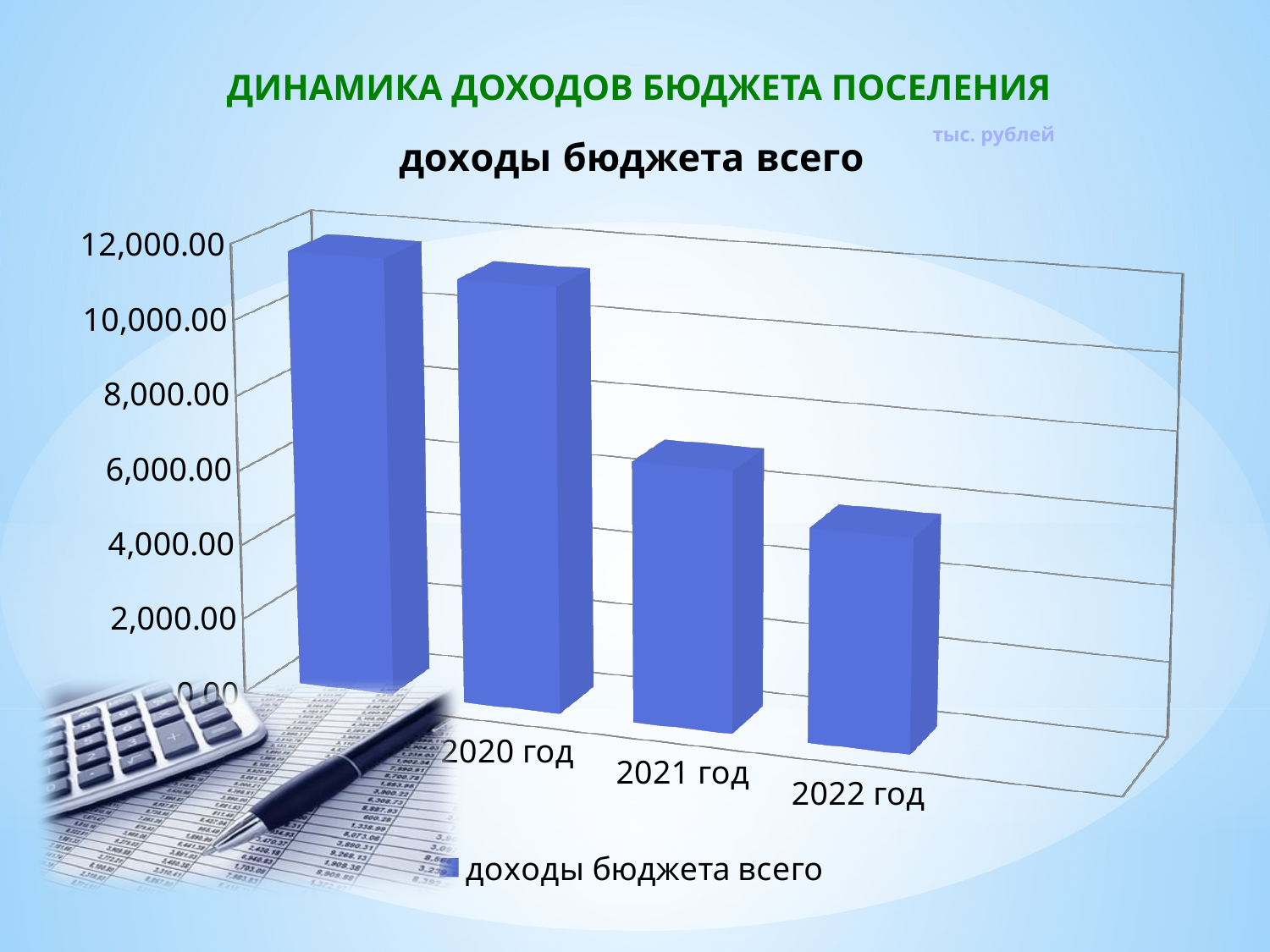
Is the value for 2021 год greater or less than 8,000.00? less Is the value for 2020 год greater or less than 10,000.00? greater Is the value for 2022 год greater or less than 6,000.00? less Do the values rise or fall from left to right along the x axis? fall How many bars are plotted in the chart? 4 How many series does the legend list? 1 What kind of chart is shown on the slide? bar chart What is the title of the chart? доходы бюджета всего Which is larger, the value for 2020 год or the value for 2022 год? 2020 год